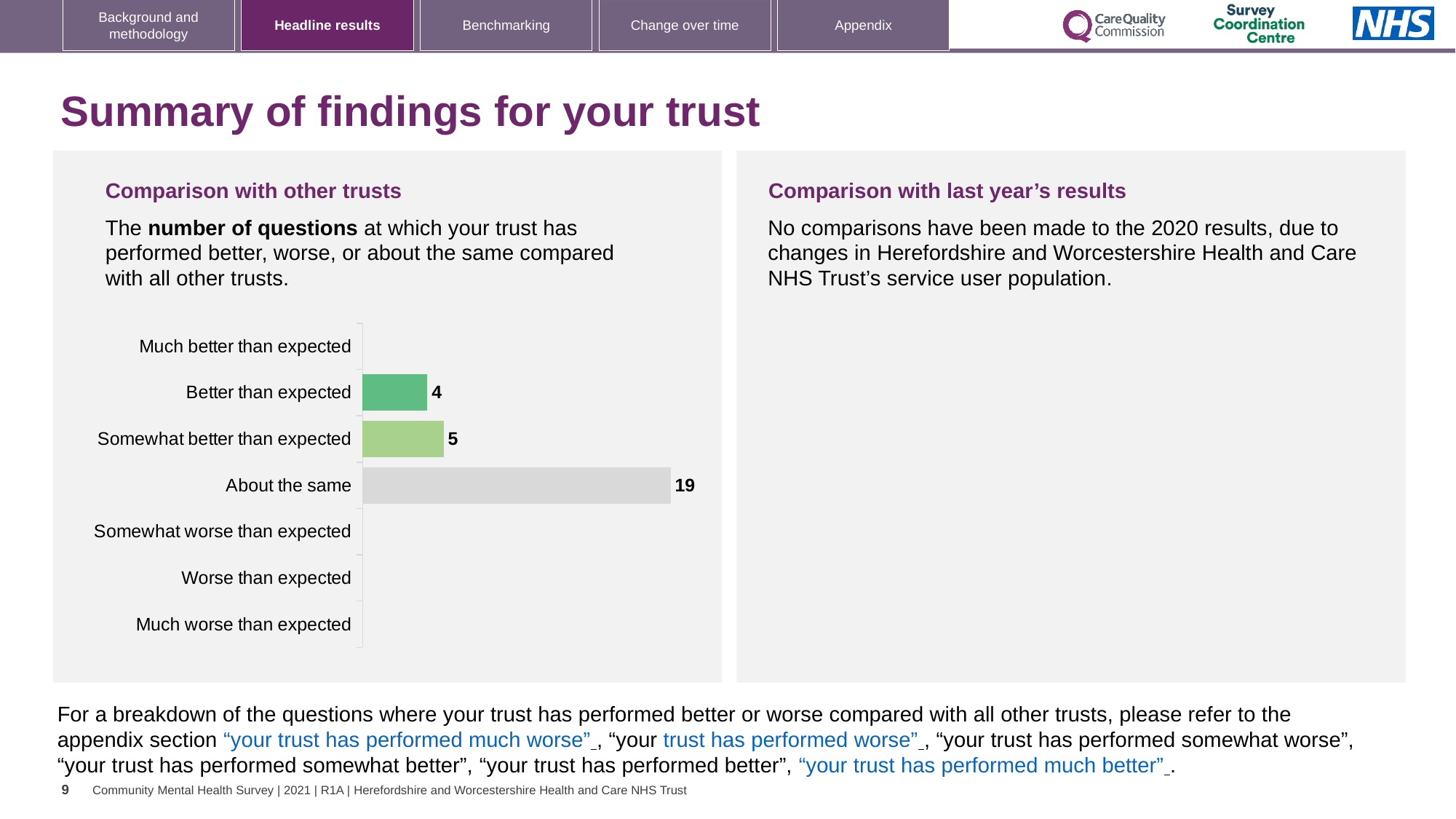
What is the difference between the 'About the same' value and the 'Somewhat better than expected' value? 14 What is the value for 'Somewhat better than expected'? 5 How many questions fall in the 'About the same' category? 19 What kind of chart is shown on the slide? Bar chart What is the value for 'Better than expected'? 4 Which category has the highest number of questions? About the same What is the difference between 'Somewhat better than expected' and 'Better than expected'? 1 How many categories have a visible bar with a value? 3 Which is larger: the value for 'Better than expected' or the value for 'Somewhat better than expected'? Somewhat better than expected What colour is the bar for 'About the same'? Grey How many categories are listed on the chart's axis? 7 What is the total number of questions across the 'Better than expected', 'Somewhat better than expected' and 'About the same' categories? 28